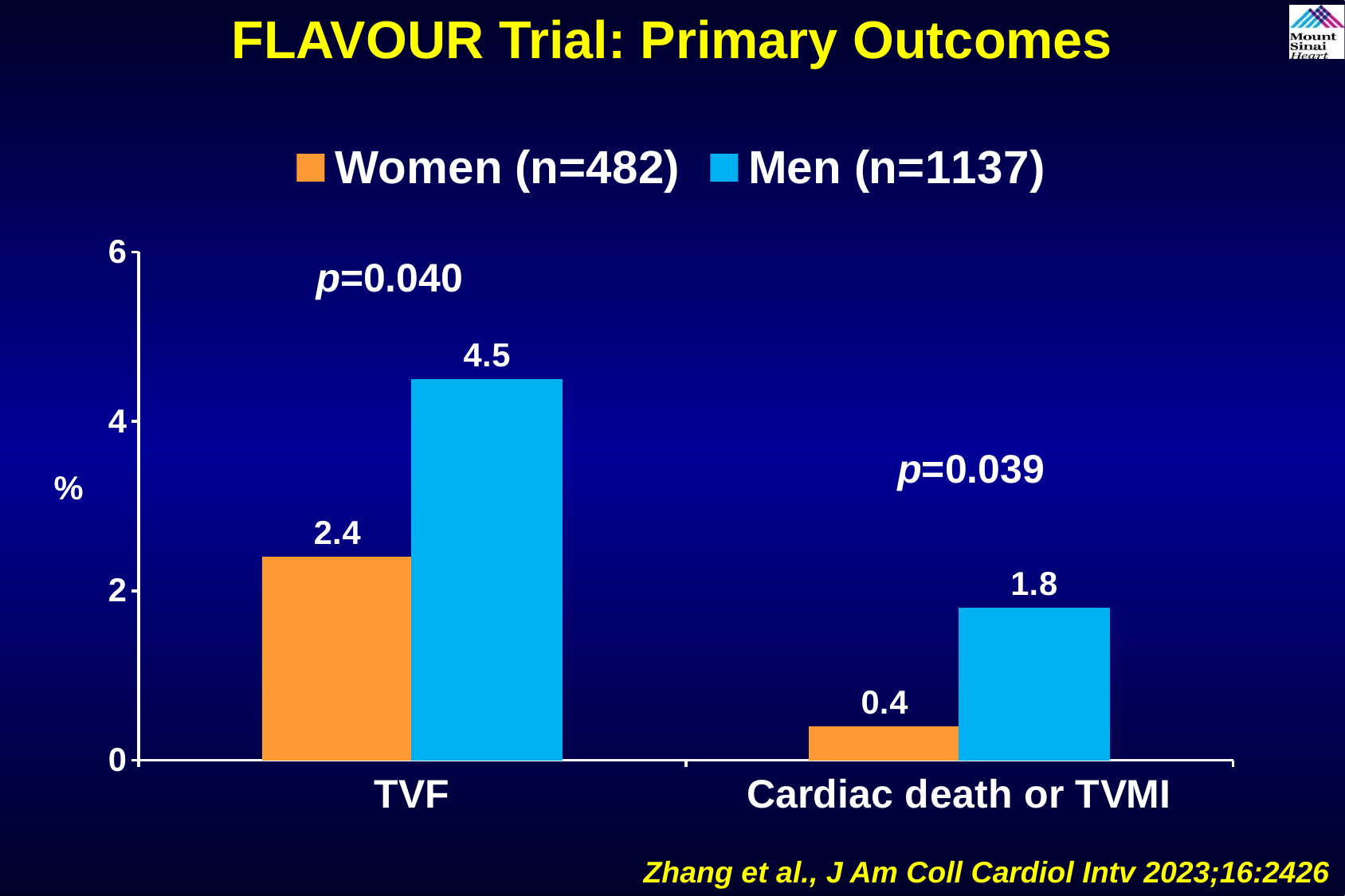
What is the value for Women (n=482) for TVF? 2.4 What kind of chart is shown on the slide? Bar chart How many categories are shown on the x axis? 2 For TVF, which series has the larger value, Women (n=482) or Men (n=1137)? Men (n=1137) Which category has the highest value for Men (n=1137)? TVF What is the difference between the Men and Women values for TVF? 2.1 What is the value for Women (n=482) for Cardiac death or TVMI? 0.4 What is the value for Men (n=1137) for TVF? 4.5 What is the value for Men (n=1137) for Cardiac death or TVMI? 1.8 What is the difference between the Men and Women values for Cardiac death or TVMI? 1.4 Which category has the lowest value for Women (n=482)? Cardiac death or TVMI How many series does the legend list? 2